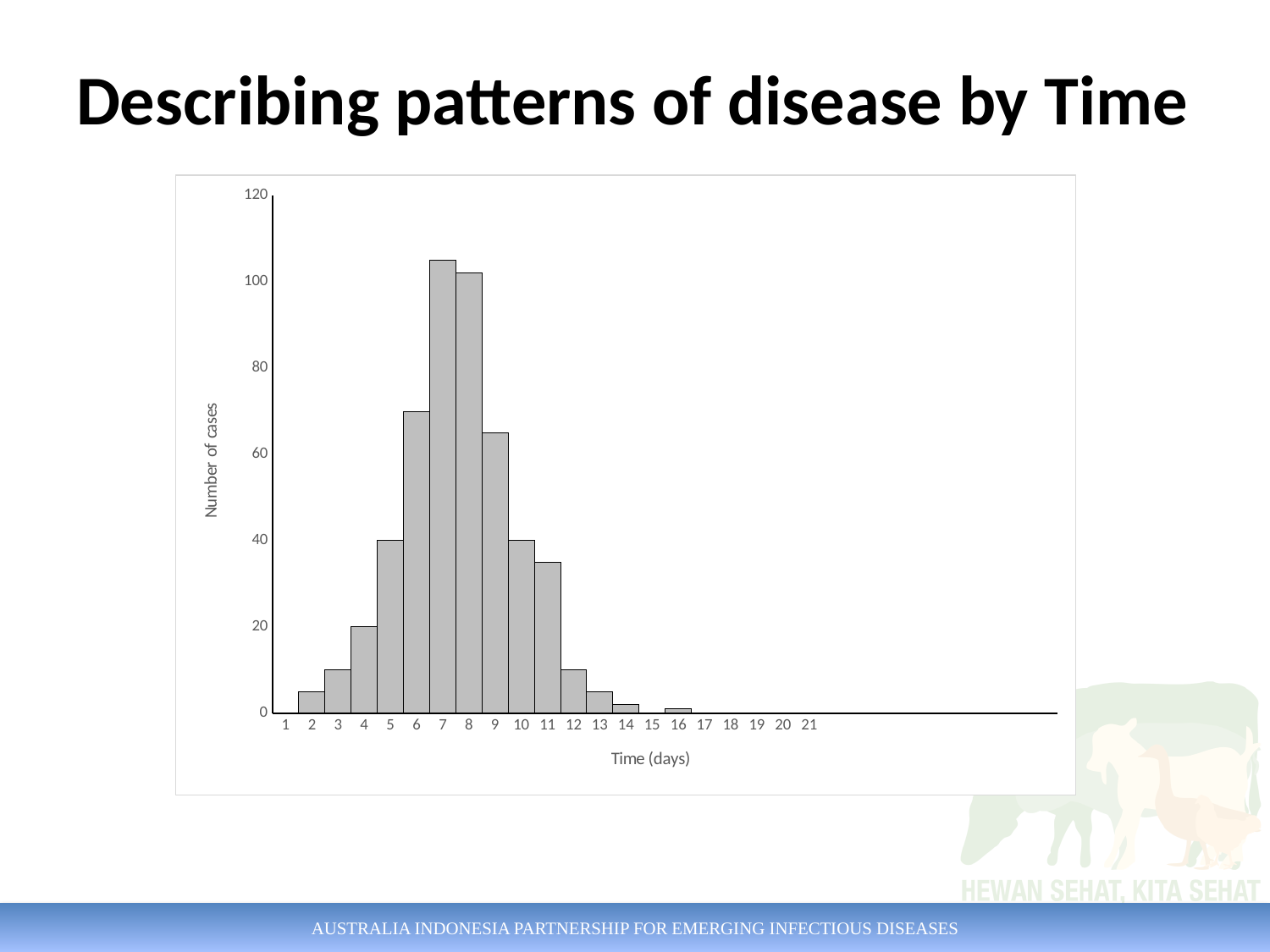
Which day has more cases, day 4 or day 12? day 4 Is the number of cases on day 9 greater or less than 60? greater What is the label of the y axis? Number of cases What kind of chart is shown on the slide? bar chart Is the number of cases on day 7 greater or less than 100? greater How many days are labelled on the x axis? 21 Is the number of cases on day 11 greater or less than 40? less What is the number of cases on day 5? 40 What is the number of cases on day 10? 40 On which day is the number of cases highest? 7 What is the number of cases on day 4? 20